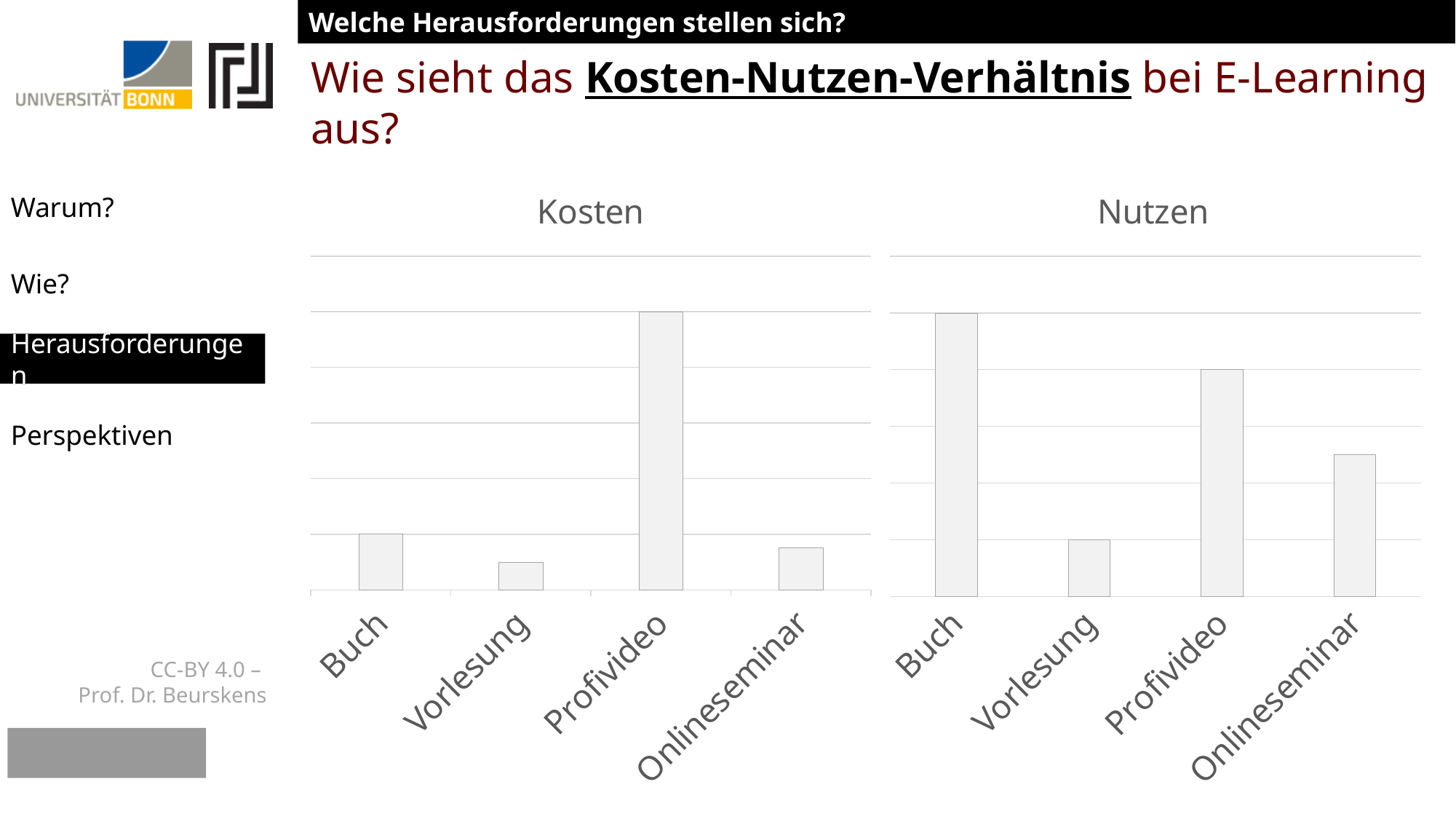
What is the title of the chart on the right side of the slide? Nutzen In the "Nutzen" chart, which is larger, the value for Onlineseminar or the value for Vorlesung? Onlineseminar In the "Kosten" chart, which category has the highest value? Profivideo How many categories are shown in the "Nutzen" chart? 4 In the "Nutzen" chart, which category has the highest value? Buch How many categories are shown in the "Kosten" chart? 4 In the "Kosten" chart, which is larger, the value for Buch or the value for Vorlesung? Buch What is the title of the chart on the left side of the slide? Kosten In the "Kosten" chart, which category has the lowest value? Vorlesung In the "Nutzen" chart, which category has the lowest value? Vorlesung What kind of chart is the "Kosten" chart? bar chart In the "Nutzen" chart, which is larger, the value for Profivideo or the value for Onlineseminar? Profivideo